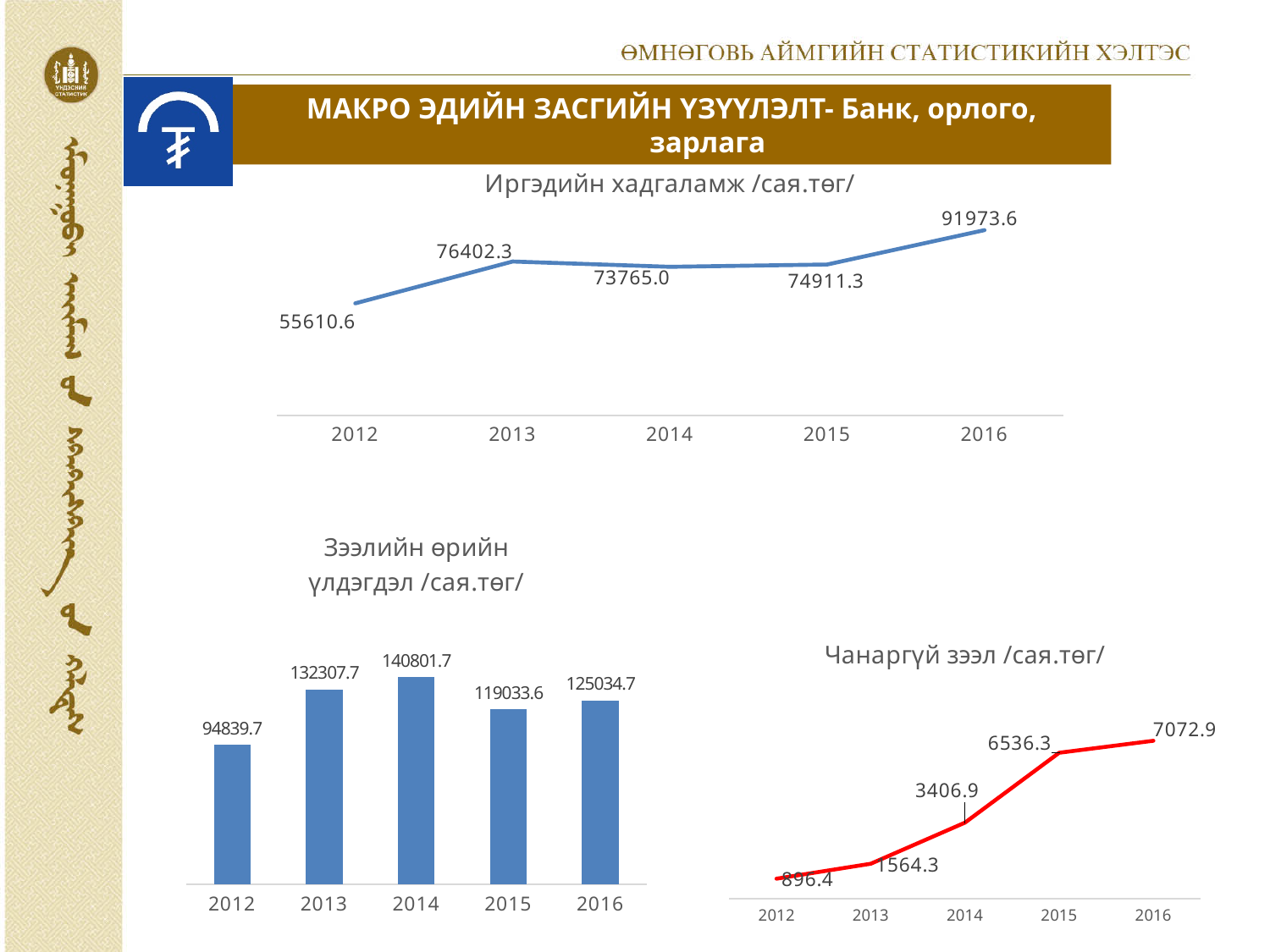
In the chart titled 'Иргэдийн хадгаламж /сая.төг/', which year has the lowest value? 2012 In the chart titled 'Зээлийн өрийн үлдэгдэл /сая.төг/', what is the value for 2015? 119033.6 In the chart titled 'Иргэдийн хадгаламж /сая.төг/', what is the difference between the 2013 and 2014 values? 2637.3 In the chart titled 'Чанаргүй зээл /сая.төг/', do the values rise or fall from 2012 to 2016? rise What kind of chart is the one titled 'Зээлийн өрийн үлдэгдэл /сая.төг/'? bar chart In the chart titled 'Зээлийн өрийн үлдэгдэл /сая.төг/', which is larger, the value for 2013 or the value for 2016? 2013 In the chart titled 'Чанаргүй зээл /сая.төг/', what is the difference between the 2016 and 2015 values? 536.6 In the chart titled 'Зээлийн өрийн үлдэгдэл /сая.төг/', which year has the highest value? 2014 In the chart titled 'Иргэдийн хадгаламж /сая.төг/', how many years are plotted? 5 In the chart titled 'Чанаргүй зээл /сая.төг/', what is the value for 2015? 6536.3 In the chart titled 'Иргэдийн хадгаламж /сая.төг/', what is the value for 2016? 91973.6 What colour is the line in the chart titled 'Чанаргүй зээл /сая.төг/'? red